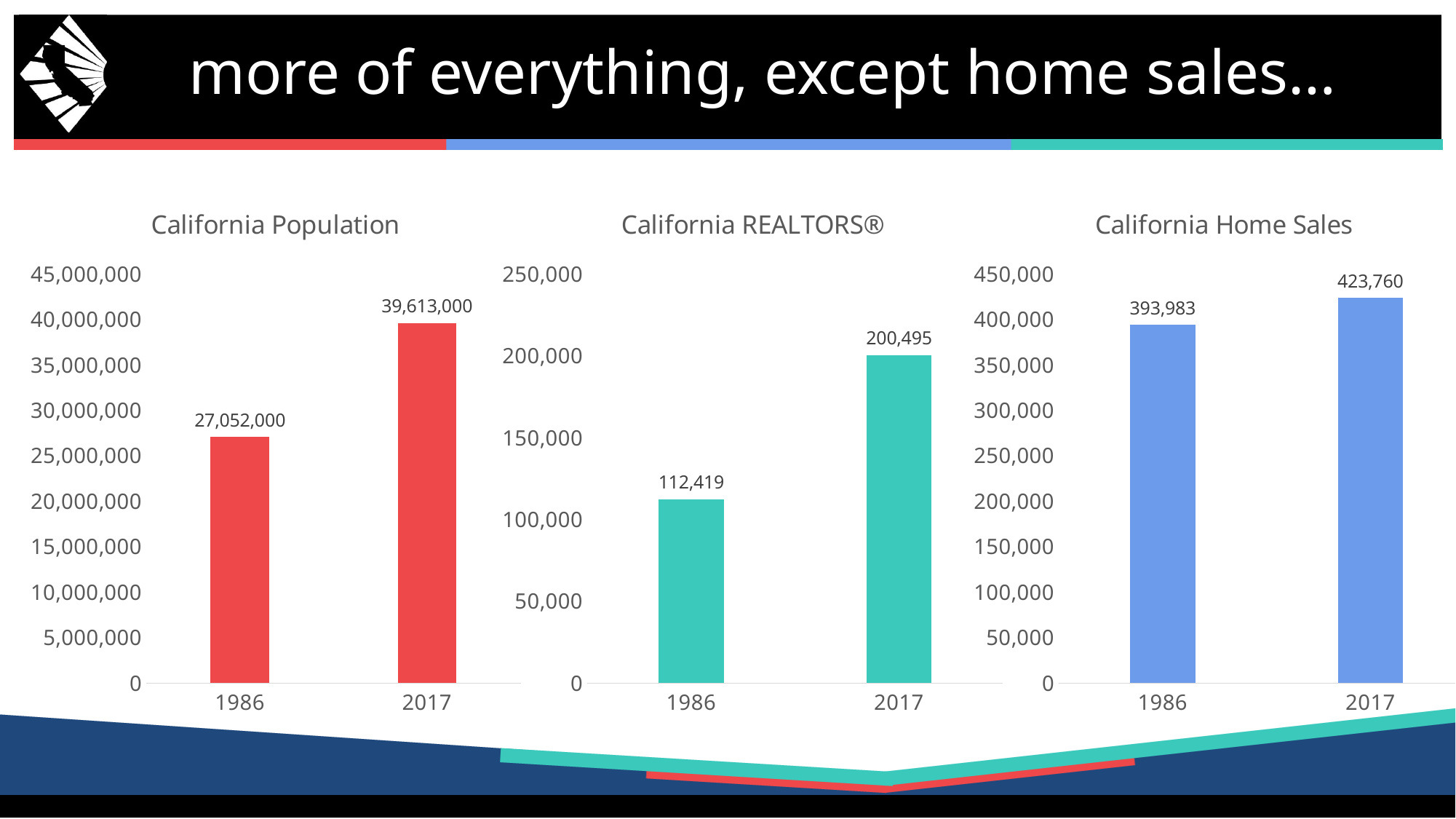
In the California Population chart, what is the value for 1986? 27,052,000 In the California Population chart, what is the value for 2017? 39,613,000 How many charts are shown on the slide? 3 In the California REALTORS® chart, what is the difference between the 2017 and 1986 values? 88,076 In the California REALTORS® chart, what is the value for 2017? 200,495 In the California REALTORS® chart, which year has the higher value? 2017 In the California Population chart, what is the difference between the 2017 and 1986 values? 12,561,000 In the California Home Sales chart, what is the value for 1986? 393,983 In the California REALTORS® chart, what is the value for 1986? 112,419 In the California Home Sales chart, what is the difference between the 2017 and 1986 values? 29,777 In the California Home Sales chart, what is the value for 2017? 423,760 What kind of chart is the California Home Sales chart? Bar chart